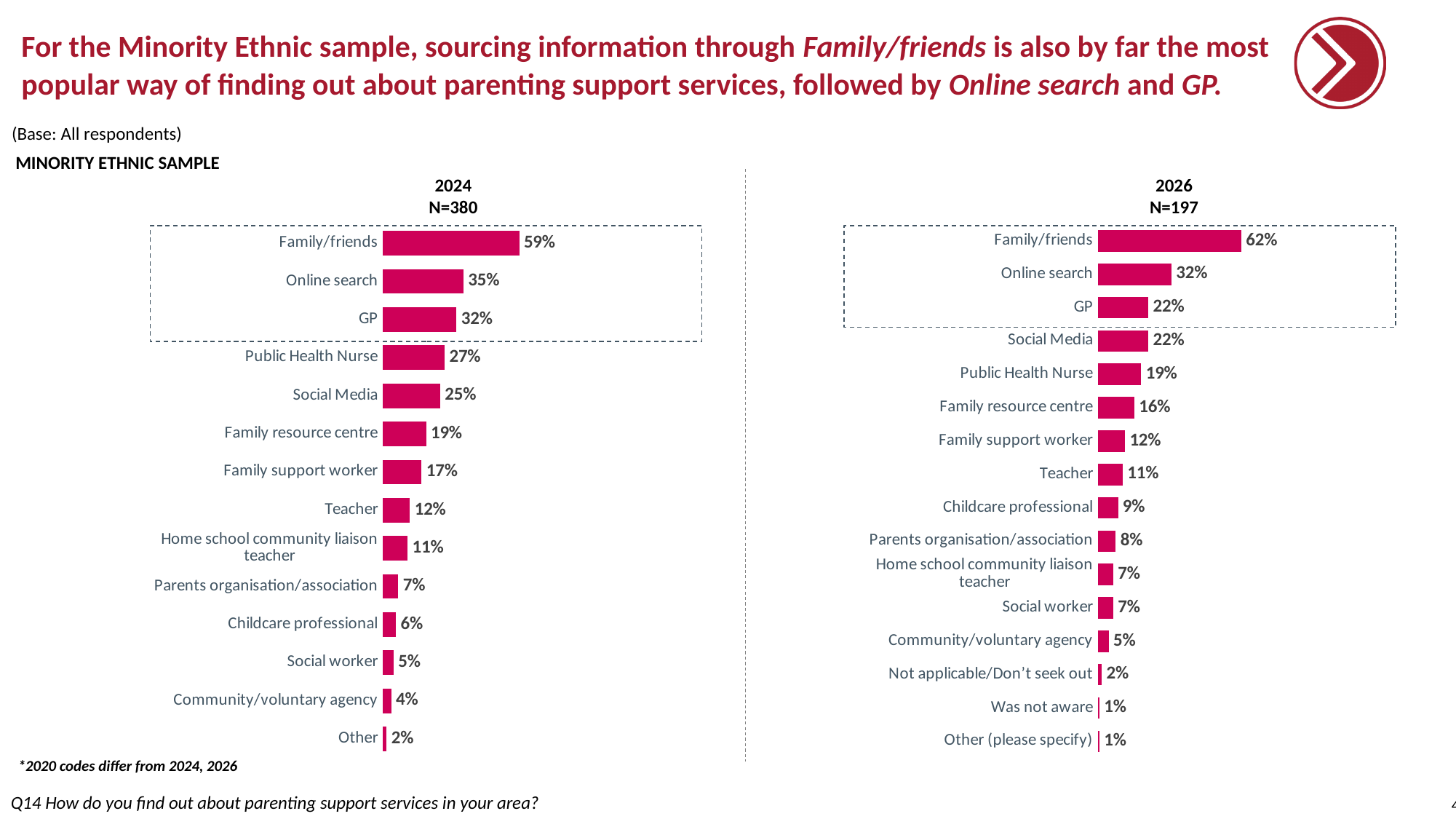
Which is larger: Social Media in the 2024 (N=380) chart or Social Media in the 2026 (N=197) chart? 2024 (25%) In the 2024 (N=380) chart, which category has the lowest value? Other In the 2026 (N=197) chart, what percentage is shown for GP? 22% How many categories are shown in the 2024 (N=380) chart? 14 In the 2024 (N=380) chart, what is the difference between Online search and GP? 3 percentage points In the 2026 (N=197) chart, what percentage is shown for Was not aware? 1% In the 2026 (N=197) chart, which category has the highest value? Family/friends What type of chart is used on this slide? Bar chart In the 2024 (N=380) chart, what percentage is shown for Family/friends? 59% In the 2024 (N=380) chart, what percentage is shown for Public Health Nurse? 27% In the 2026 (N=197) chart, what is the difference between Family/friends and Online search? 30 percentage points How many categories are shown in the 2026 (N=197) chart? 16